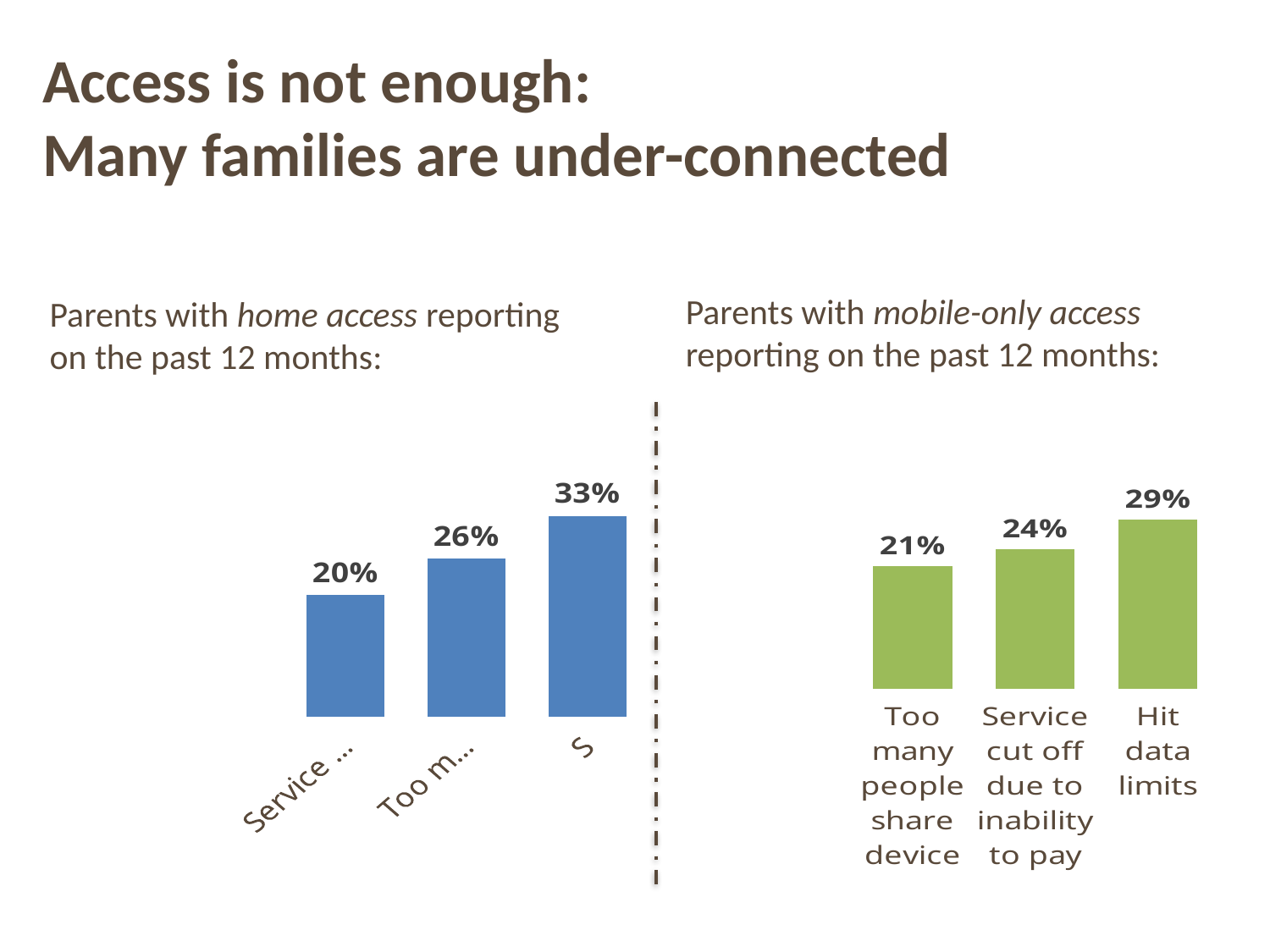
In the mobile-only access chart on the right, which category has the highest value? Hit data limits In the home access chart on the left, what is the value of the tallest bar? 33% What type of chart is the mobile-only access chart on the right? bar chart In the home access chart on the left, what is the value of the middle bar? 26% In the home access chart on the left, what is the value of the leftmost bar? 20% In the mobile-only access chart on the right, what percentage of parents reported service cut off due to inability to pay? 24% In the mobile-only access chart on the right, which category has the lowest value? Too many people share device In the mobile-only access chart on the right, what percentage of parents reported hitting data limits? 29% In the mobile-only access chart on the right, what percentage of parents reported that too many people share the device? 21% In the home access chart on the left, do the values rise or fall from left to right? rise In the mobile-only access chart on the right, what is the difference between the value for hitting data limits and the value for too many people sharing the device? 8% How many bars are in the home access chart on the left? 3